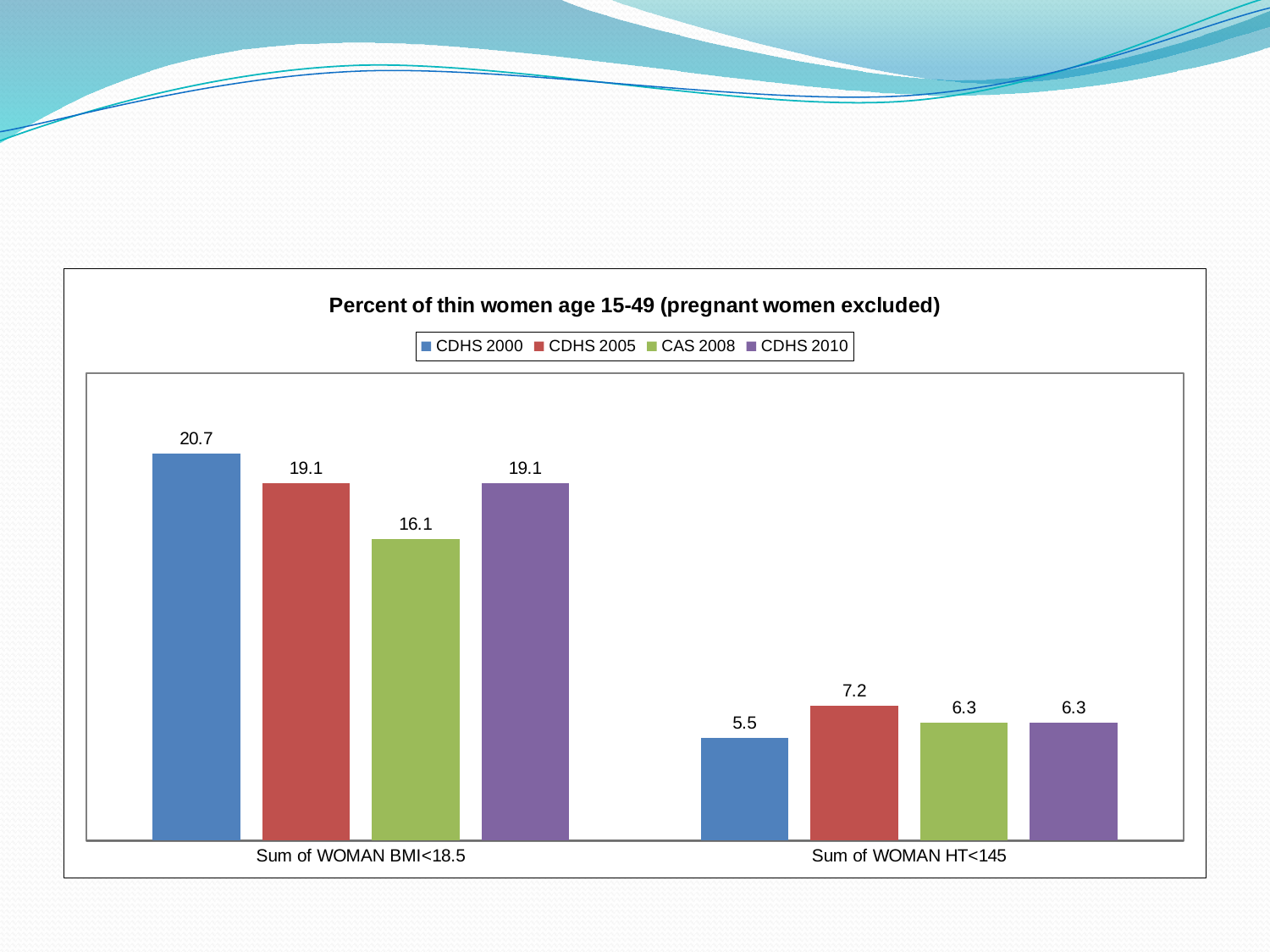
Which series has the highest value in the 'Sum of WOMAN BMI<18.5' category? CDHS 2000 Which series has the lowest value in the 'Sum of WOMAN HT<145' category? CDHS 2000 How many categories are shown on the x axis? 2 What is the value for CDHS 2010 in the 'Sum of WOMAN HT<145' category? 6.3 What is the title of the chart? Percent of thin women age 15-49 (pregnant women excluded) What is the value for CDHS 2000 in the 'Sum of WOMAN BMI<18.5' category? 20.7 What is the difference between the CDHS 2000 and CAS 2008 values in the 'Sum of WOMAN BMI<18.5' category? 4.6 What is the value for CAS 2008 in the 'Sum of WOMAN BMI<18.5' category? 16.1 What is the value for CDHS 2005 in the 'Sum of WOMAN HT<145' category? 7.2 Which is larger in the 'Sum of WOMAN HT<145' category: CDHS 2005 or CAS 2008? CDHS 2005 How many series does the legend list? 4 What is the difference between the CDHS 2005 and CDHS 2000 values in the 'Sum of WOMAN HT<145' category? 1.7